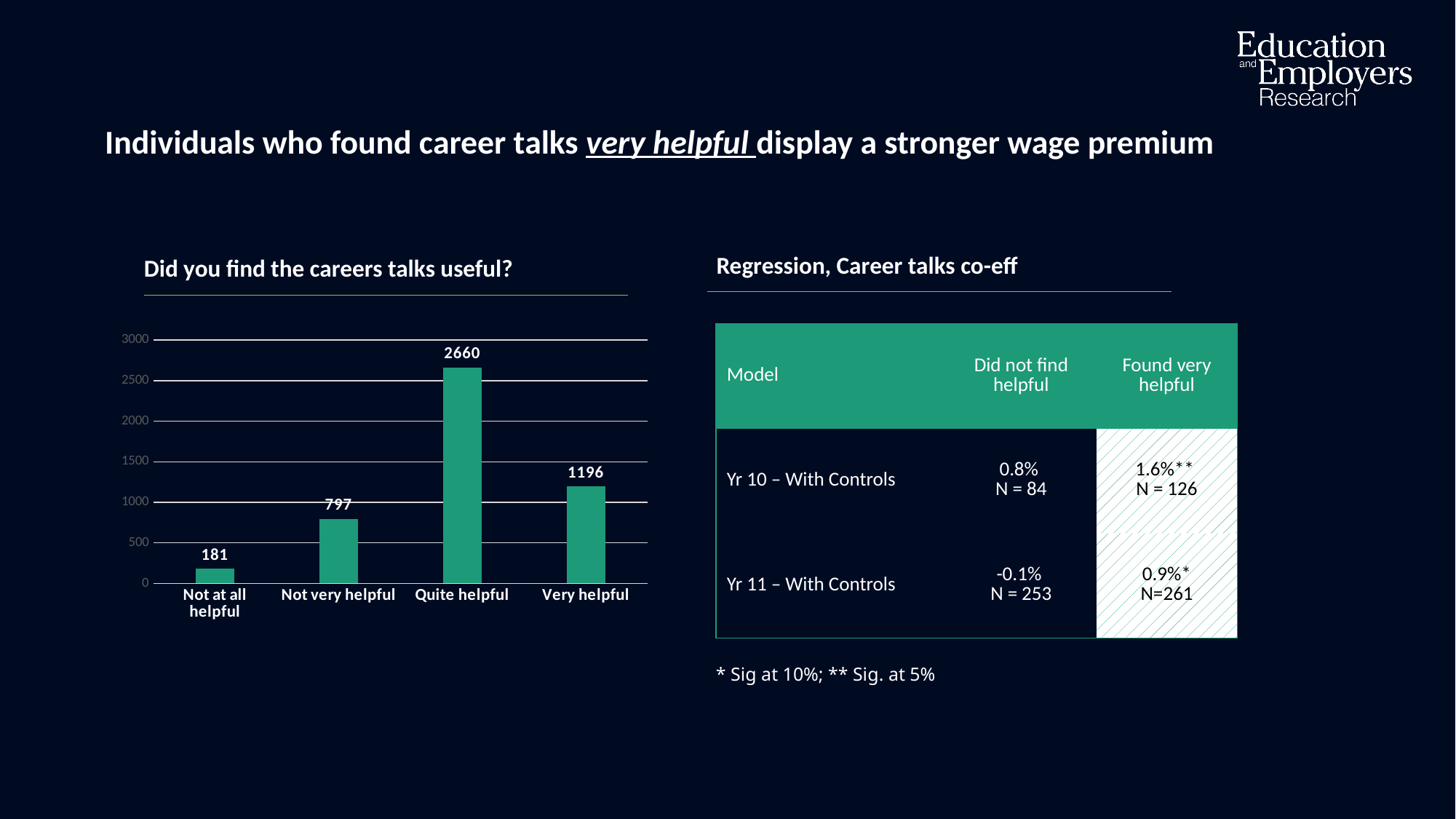
Which category has the lowest value in the chart? Not at all helpful What is the value for "Not at all helpful" in the chart? 181 What kind of chart is shown on the slide? Bar chart What is the difference between the values for "Quite helpful" and "Very helpful"? 1464 What is the value for "Not very helpful" in the chart? 797 How many categories are shown in the chart? 4 Which is larger, the value for "Very helpful" or the value for "Not very helpful"? Very helpful What is the value for "Very helpful" in the chart? 1196 What is the difference between the values for "Not very helpful" and "Not at all helpful"? 616 What is the value for "Quite helpful" in the chart "Did you find the careers talks useful?"? 2660 Which category has the highest value in the chart? Quite helpful What is the title of the chart on the slide? Did you find the careers talks useful?